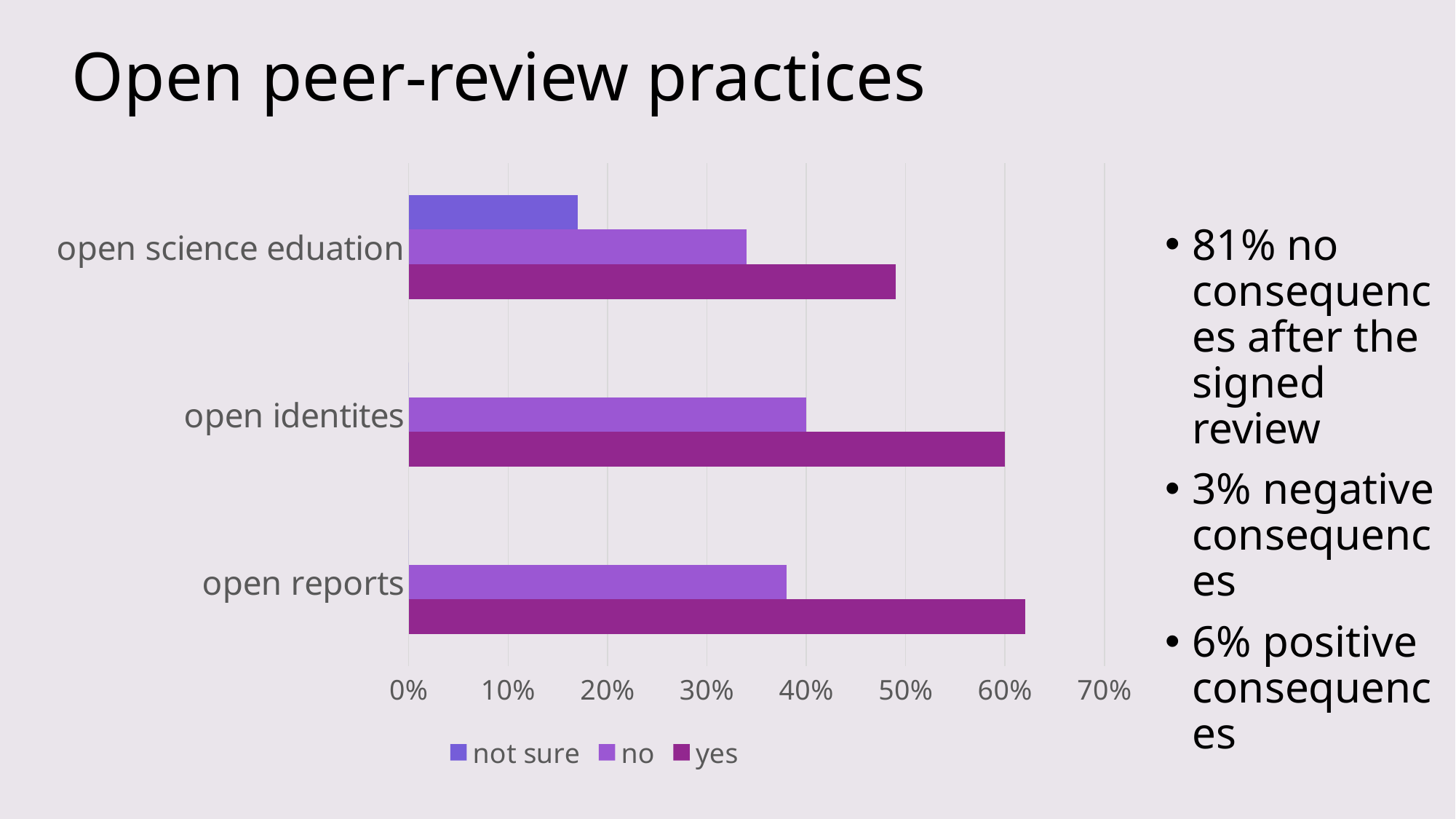
How many categories are shown on the chart? 3 What is the title of the slide containing the chart? Open peer-review practices What is the 'yes' value for open identites? 60% What kind of chart is shown on the slide? bar chart How many series does the chart legend list? 3 Which category has the lowest 'yes' value? open science eduation What is the 'no' value for open identites? 40% For open science eduation, which is larger: the 'no' value or the 'not sure' value? no Is the 'not sure' value for open science eduation greater or less than 20%? less What are the legend entries of the chart? not sure, no, yes Is the 'yes' value for open science eduation greater or less than 40%? greater Is the 'yes' value for open reports greater or less than 50%? greater